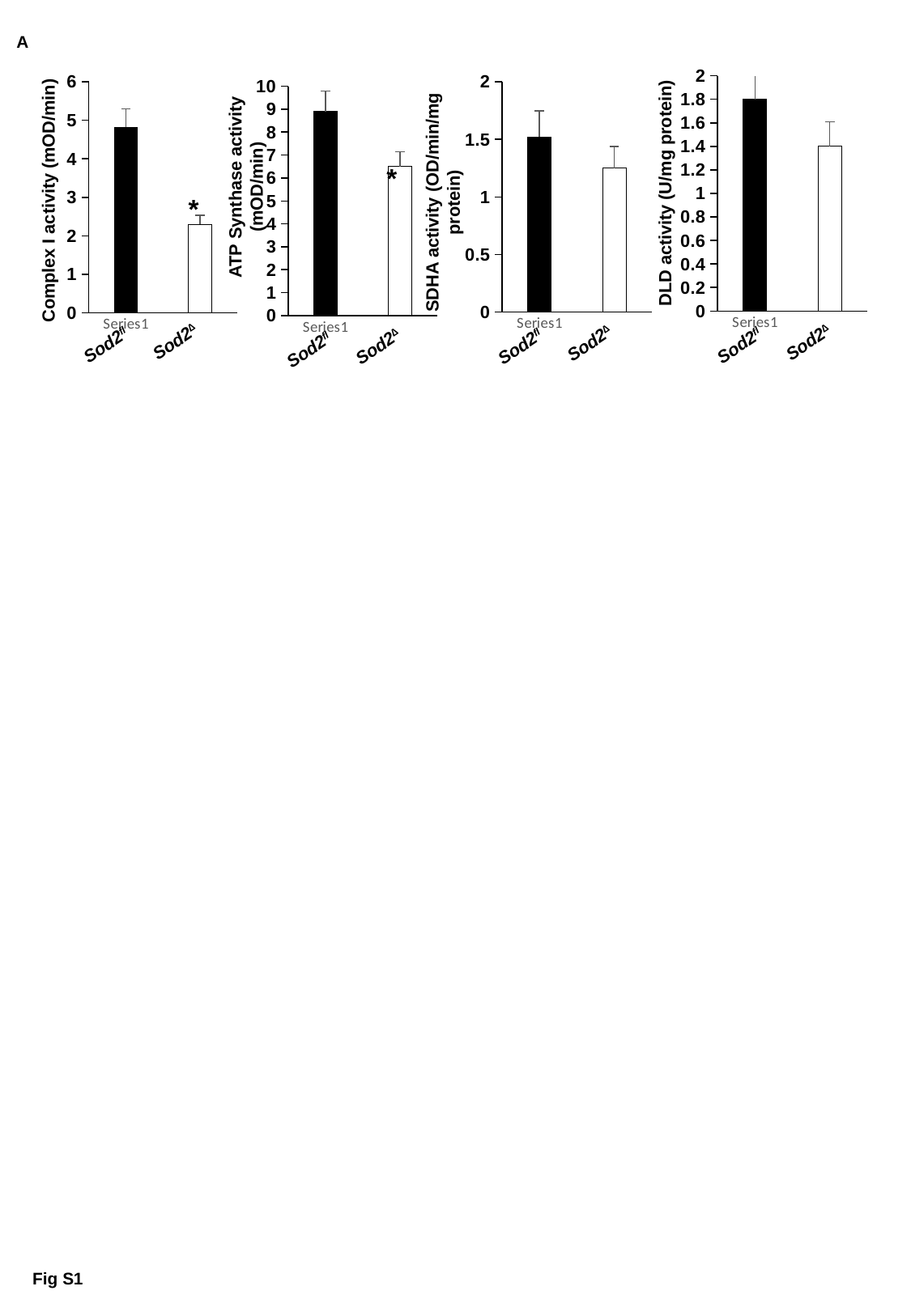
In the Complex I activity chart (leftmost), which category has the higher bar, Sod2fl or Sod2Δ? Sod2fl In the Complex I activity chart (leftmost), is the value for Sod2fl greater or less than 4? greater In the ATP Synthase activity chart (second from left), is the value for Sod2fl greater or less than 8? greater How many categories are plotted in the Complex I activity chart (leftmost)? 2 In the DLD activity chart (rightmost), which category has the higher bar? Sod2fl In the ATP Synthase activity chart (second from left), which category has the lower bar? Sod2Δ In the SDHA activity chart (third from left), is the value for Sod2fl greater or less than 1? greater What kind of chart is the DLD activity chart (rightmost)? bar chart How many charts are shown on the slide? 4 In the SDHA activity chart (third from left), which bar is taller, Sod2fl or Sod2Δ? Sod2fl